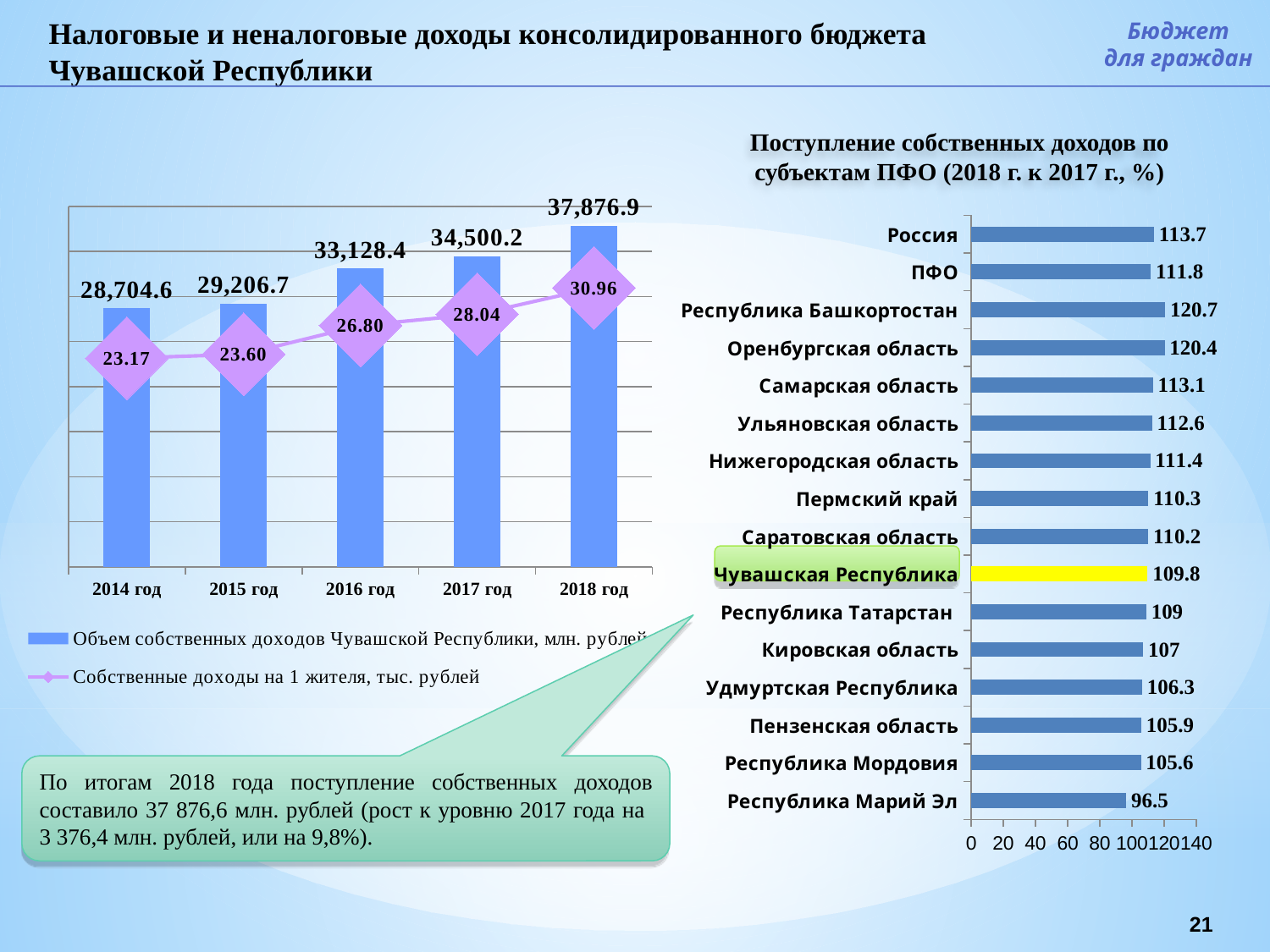
On the chart titled 'Поступление собственных доходов по субъектам ПФО', what is the value for Чувашская Республика? 109.8 On the left chart, which year has the lowest value for Собственные доходы на 1 жителя? 2014 год On the chart titled 'Поступление собственных доходов по субъектам ПФО', which region has the lowest value? Республика Марий Эл On the left chart, what is the difference between the bar values for 2018 год and 2017 год? 3,376.7 On the chart titled 'Поступление собственных доходов по субъектам ПФО', which region has the highest value? Республика Башкортостан What kind of chart is the one titled 'Поступление собственных доходов по субъектам ПФО'? bar chart On the left chart, what is the value of the bar for 2018 год? 37,876.9 On the left chart, do the bar values rise or fall from 2014 год to 2018 год? rise On the chart titled 'Поступление собственных доходов по субъектам ПФО', how many categories are shown? 16 How many series does the legend of the left chart list? 2 On the chart titled 'Поступление собственных доходов по субъектам ПФО', what is the difference between the values for Россия and ПФО? 1.9 On the left chart, what is the value of the line marker (Собственные доходы на 1 жителя) for 2016 год? 26.80